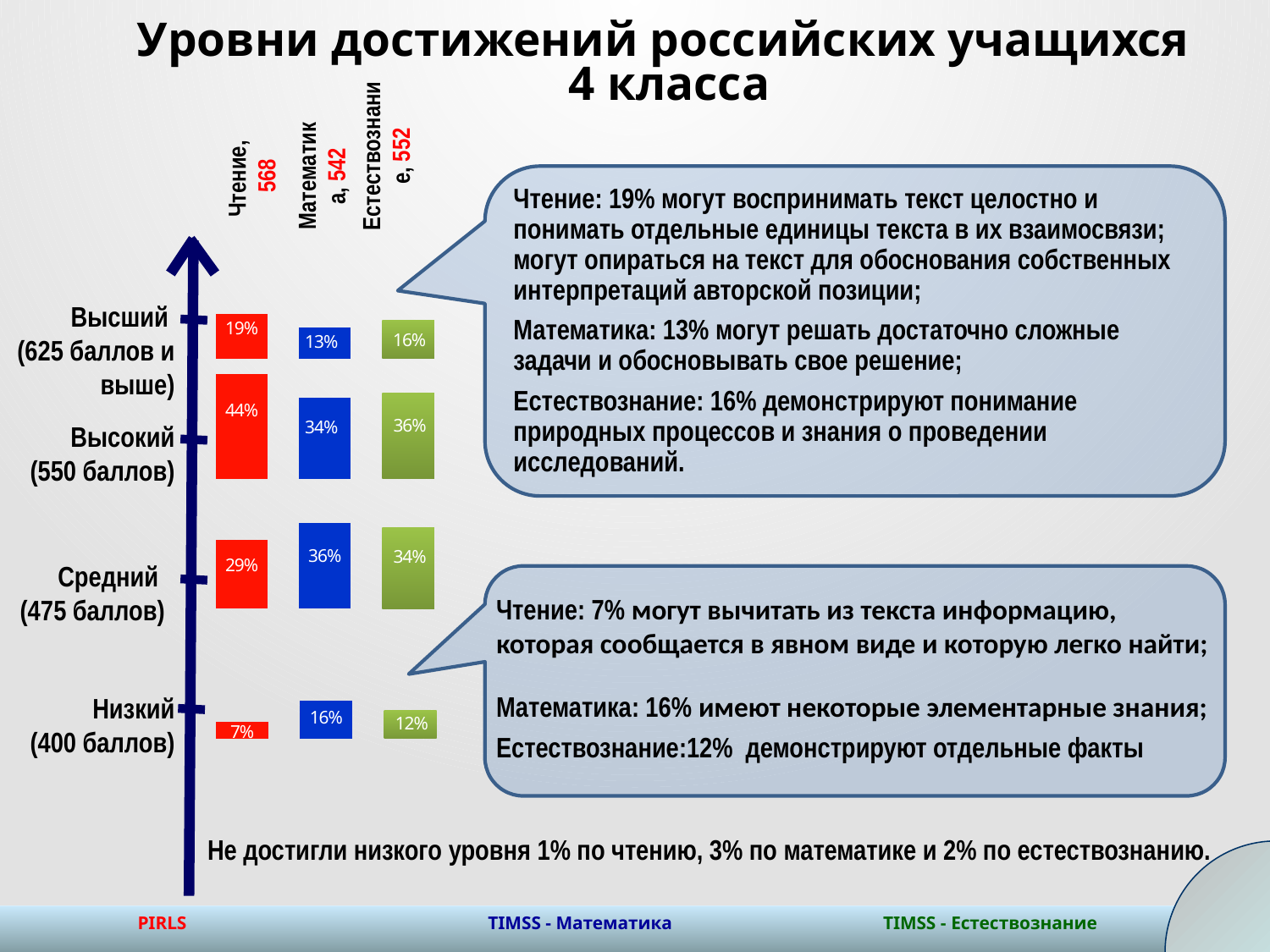
Какой процент учащихся находится на низком уровне (400 баллов) по чтению? 7% Какой процент учащихся находится на среднем уровне (475 баллов) по естествознанию? 34% Сколько предметов (серий) представлено на диаграмме? 3 Какой тип диаграммы используется на слайде? Столбчатая (bar chart) На каком уровне доля учащихся по чтению наибольшая? Высокий (550 баллов) Какой средний балл по математике указан в заголовке столбца? 542 Какой процент учащихся достиг высокого уровня (550 баллов) по математике? 34% На сколько процентных пунктов доля учащихся на высоком уровне по чтению (44%) больше, чем по математике (34%)? 10 Что больше: доля учащихся на высшем уровне по естествознанию или по математике? Естествознание (16%) Сколько уровней достижений показано на диаграмме? 4 На каком уровне доля учащихся по математике наименьшая? Высший (625 баллов и выше) Какой процент российских учащихся 4 класса достиг высшего уровня по чтению? 19%